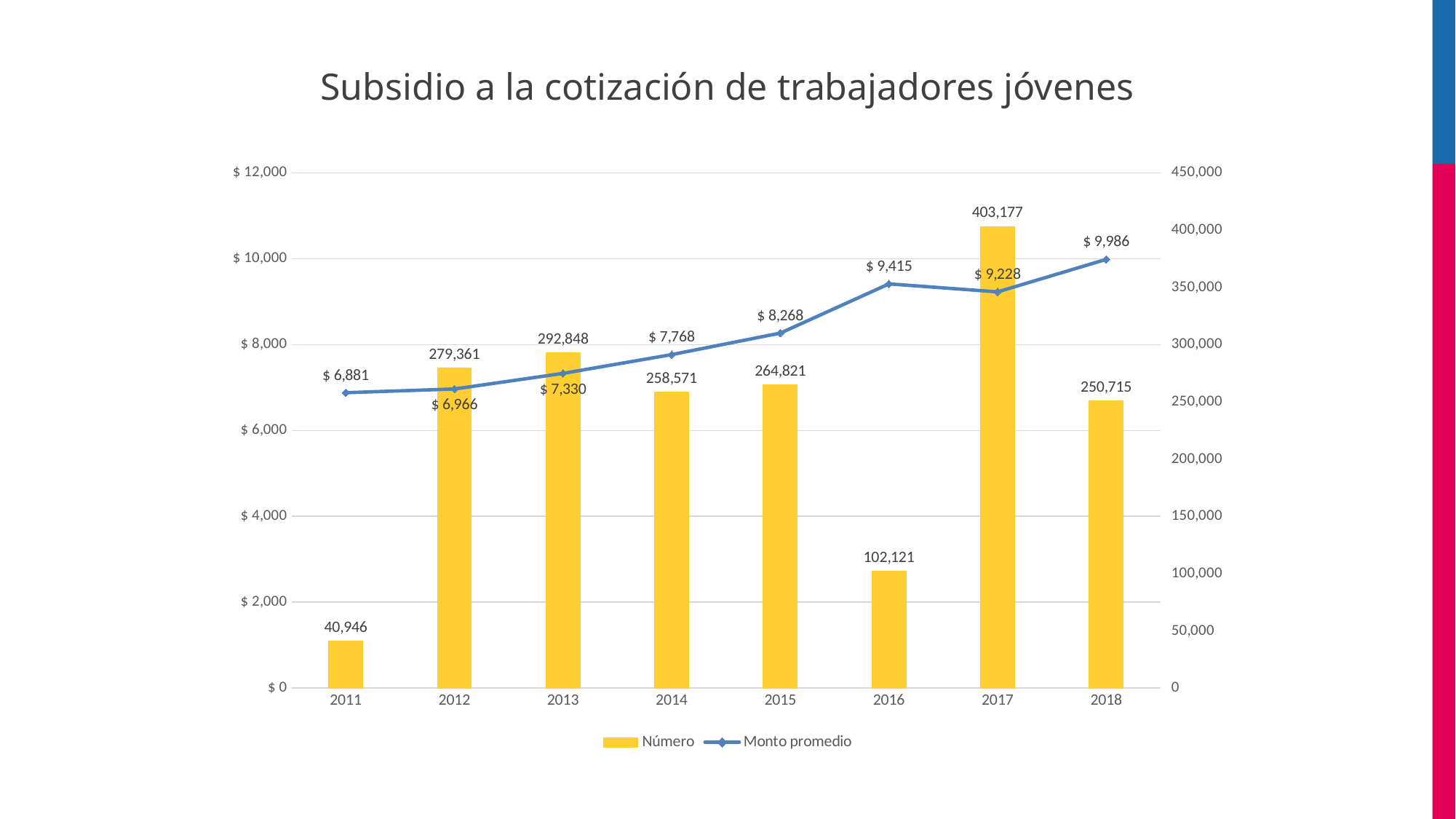
Which year has the highest Número? 2017 What is the Monto promedio for 2011? $ 6,881 Which year has the highest Monto promedio? 2018 What is the value of Número for 2017? 403,177 What is the value of Número for 2016? 102,121 Which is larger, the Monto promedio for 2016 or for 2017? 2016 How many series does the legend list? 2 What is the difference in Número between 2017 and 2018? 152,462 What is the title of the chart? Subsidio a la cotización de trabajadores jóvenes How many years are shown on the x axis? 8 Which year has the lowest Número? 2011 What kind of chart is used for the Número series? bar chart